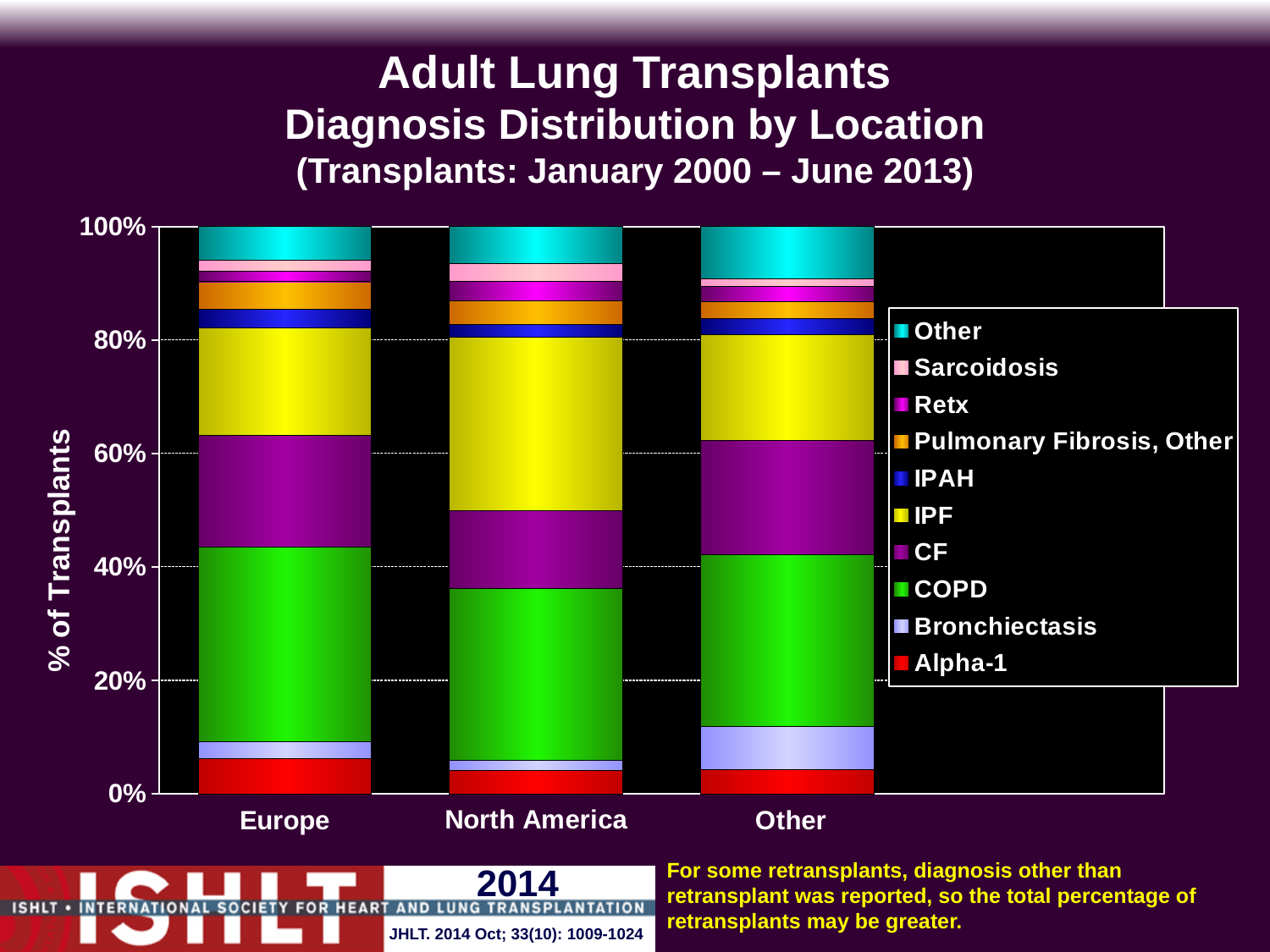
What is the total height of the stacked bar for Europe? 100% What kind of chart is shown on the slide? Stacked bar chart Is the IPF share for North America larger or smaller than the IPF share for Europe? larger Which location has the largest Bronchiectasis share of transplants? Other What is the label of the y axis? % of Transplants Is the Bronchiectasis share of transplants in Other greater or less than 20%? less Is the COPD share of transplants in Europe greater or less than 20%? greater How many diagnosis series does the legend list? 10 How many locations are shown on the x axis of the chart? 3 What transplant period does the chart title cover? January 2000 – June 2013 Which location has the largest IPF share of transplants? North America